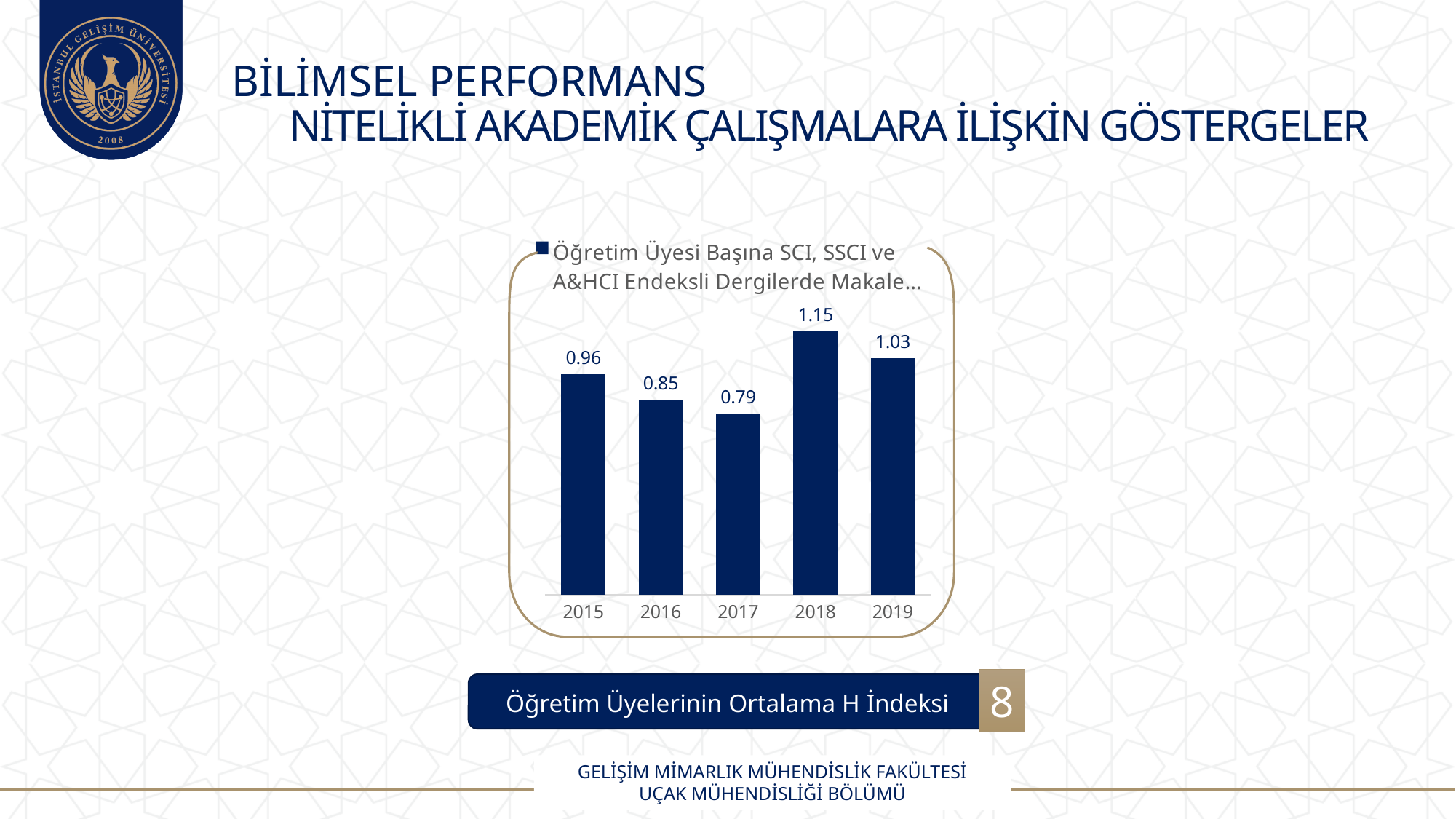
What is the difference between the values for 2018 and 2017? 0.36 How many years are shown on the x axis? 5 What is the value for 2017? 0.79 How many series does the legend list? 1 Do the values rise or fall from 2017 to 2018? rise Which year has the highest value? 2018 Which is larger, the value for 2016 or the value for 2019? 2019 What kind of chart is shown? bar chart What is the difference between the values for 2015 and 2016? 0.11 What is the value for 2015? 0.96 Which year has the lowest value? 2017 What is the value for 2019? 1.03